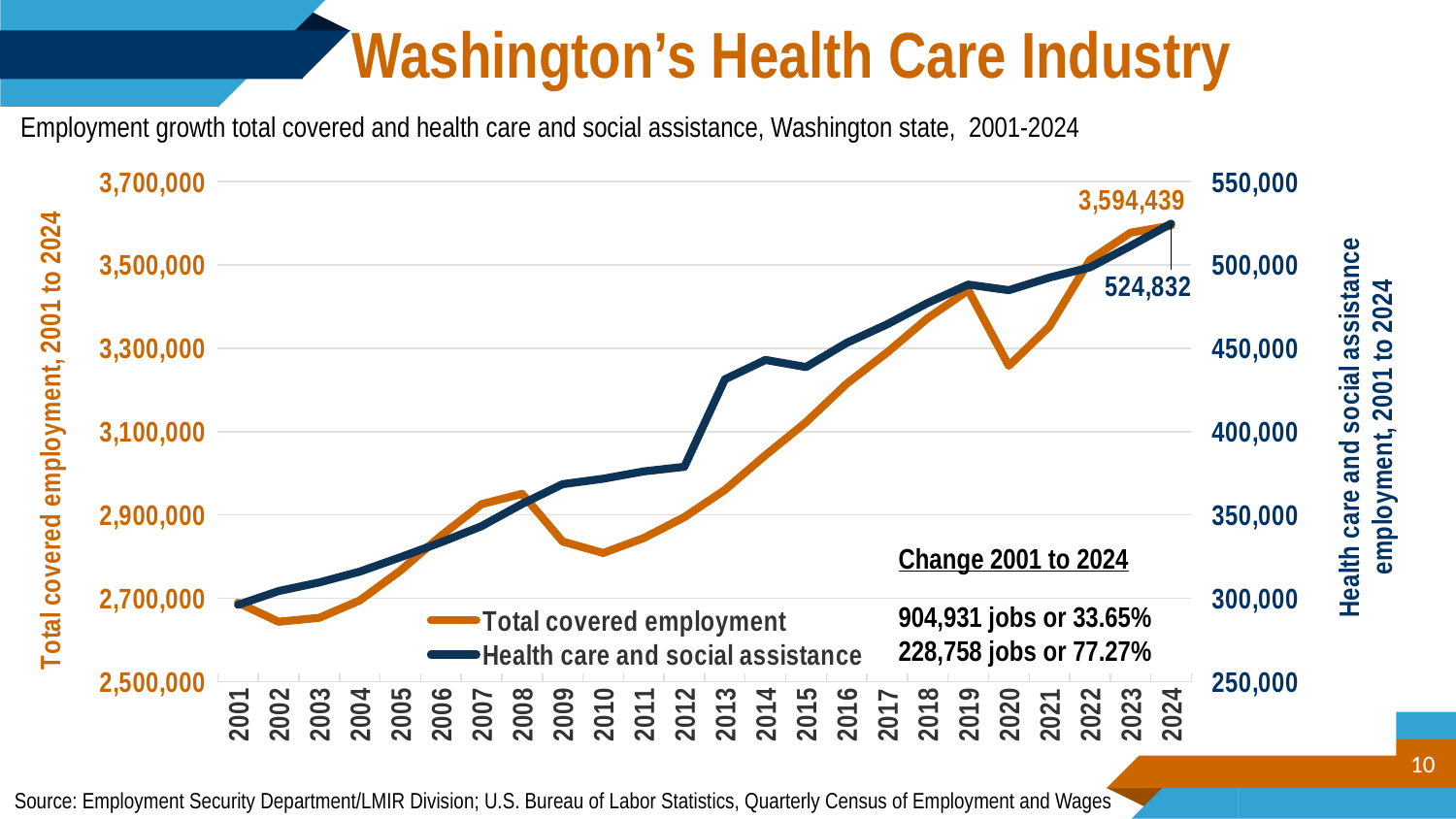
How many years are plotted along the x axis of the chart? 24 Does health care and social assistance employment generally rise or fall from 2001 to 2024? Rise Which series is drawn in orange on the chart? Total covered employment What is the value of health care and social assistance employment in 2024 according to the data label? 524,832 Is the value for total covered employment in 2020 greater or less than 3,300,000? less Is the value for health care and social assistance employment in 2013 greater or less than 400,000? greater According to the annotation, by how many jobs did health care and social assistance employment change from 2001 to 2024? 228,758 jobs or 77.27% According to the annotation, by how many jobs did total covered employment change from 2001 to 2024? 904,931 jobs or 33.65% What is the value of total covered employment in 2024 according to the data label? 3,594,439 What type of chart is shown on the slide? Line chart How many series does the chart's legend list? 2 Is the value for total covered employment in 2010 greater or less than 2,900,000? less